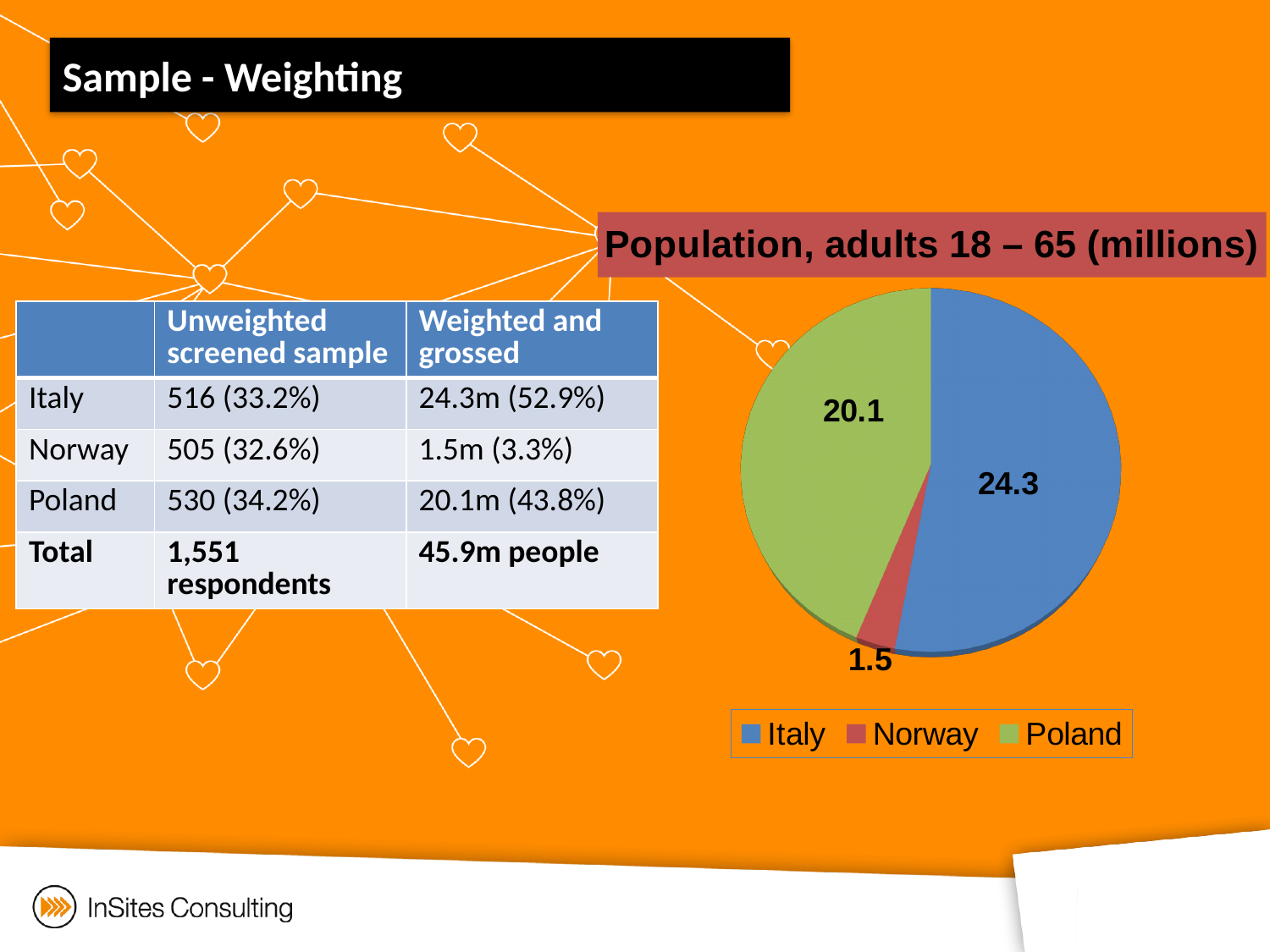
How many entries does the pie chart's legend list? 3 What is the difference between the values for Poland and Norway in the pie chart? 18.6 What is the value for Italy in the pie chart? 24.3 What kind of chart is shown on the slide? pie chart What is the title of the pie chart? Population, adults 18 – 65 (millions) Which country has the largest slice in the pie chart? Italy Which is larger in the pie chart, the value for Poland or the value for Norway? Poland What is the value for Norway in the pie chart? 1.5 What is the value for Poland in the pie chart? 20.1 What is the difference between the values for Italy and Poland in the pie chart? 4.2 Which country has the smallest slice in the pie chart? Norway How many slices does the pie chart have? 3